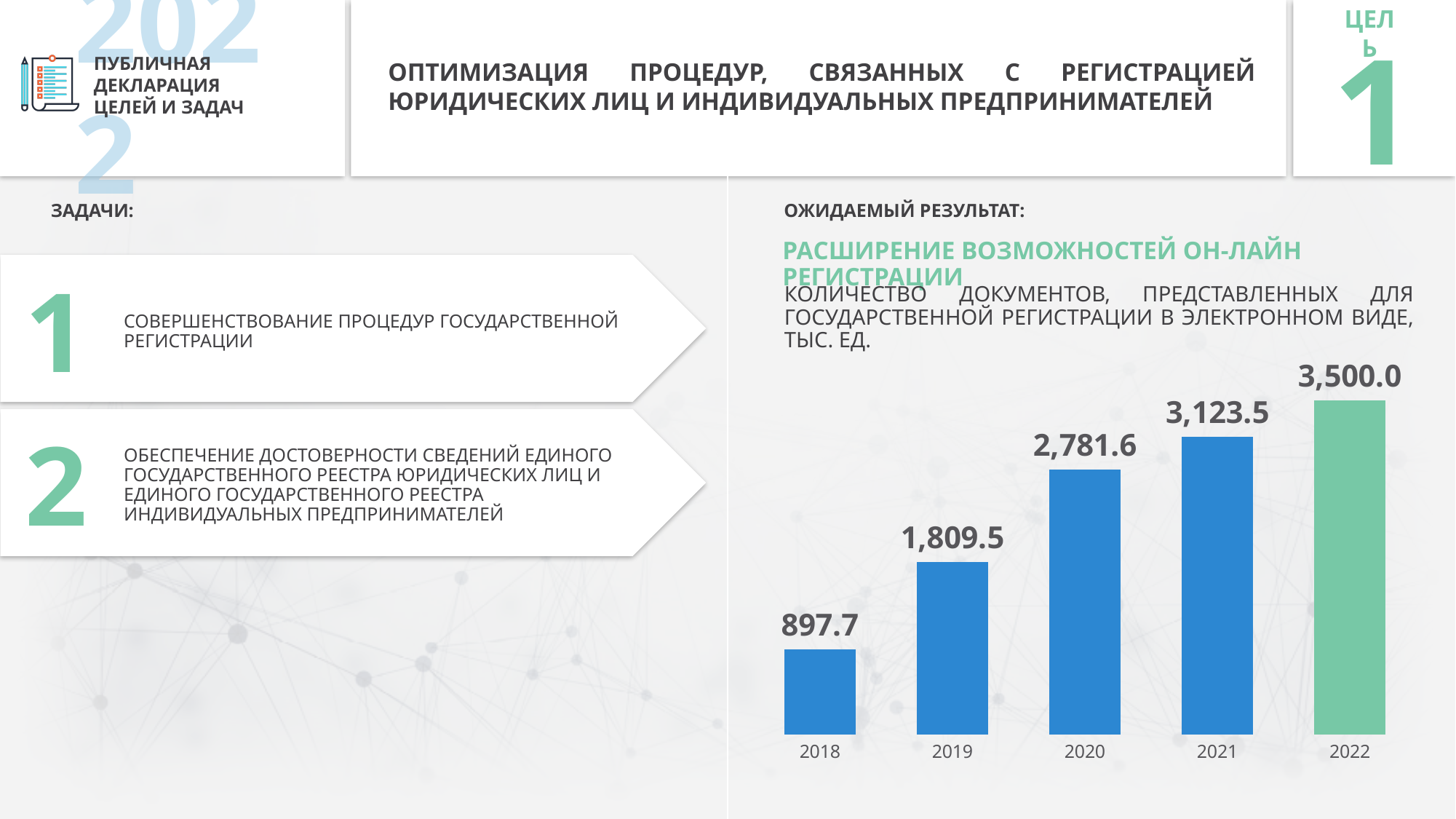
How many years are shown on the x axis? 5 What is the difference between the values for 2019 and 2018? 911.8 What is the value for 2018? 897.7 Do the values rise or fall from 2018 to 2022? rise Which bar is coloured differently from the others? 2022 Which year has the lowest value? 2018 What is the value for 2020? 2,781.6 Which year has the highest value? 2022 What is the value for 2022? 3,500.0 What is the difference between the values for 2022 and 2021? 376.5 Which is larger, the value for 2020 or the value for 2021? 2021 What kind of chart is shown on the slide? bar chart